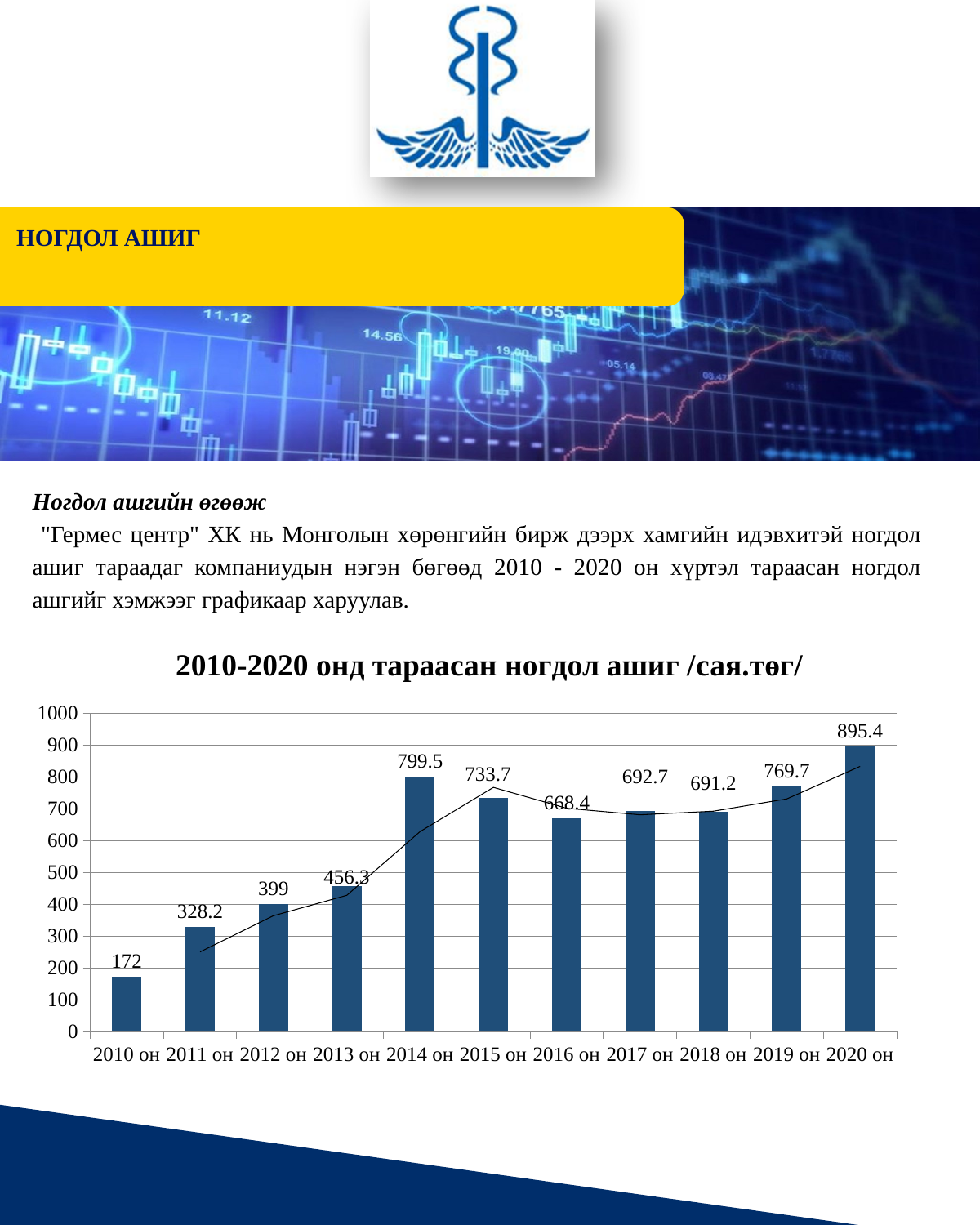
What is the dividend value shown for 2014 он? 799.5 Which is larger, the dividend value for 2015 он or for 2016 он? 2015 он How many years are shown on the x axis of the chart? 11 What is the dividend value shown for 2018 он? 691.2 Which year has the lowest dividend value in the chart? 2010 он Which year has the highest dividend value in the chart? 2020 он Is the dividend value for 2012 он greater or less than 500? less What is the difference between the dividend values for 2020 он and 2019 он? 125.7 What is the dividend value shown for 2010 он? 172 What kind of chart is used to show the dividends for 2010-2020? bar chart What is the difference between the dividend values for 2014 он and 2013 он? 343.2 What is the title of the chart? 2010-2020 онд тараасан ногдол ашиг /сая.төг/